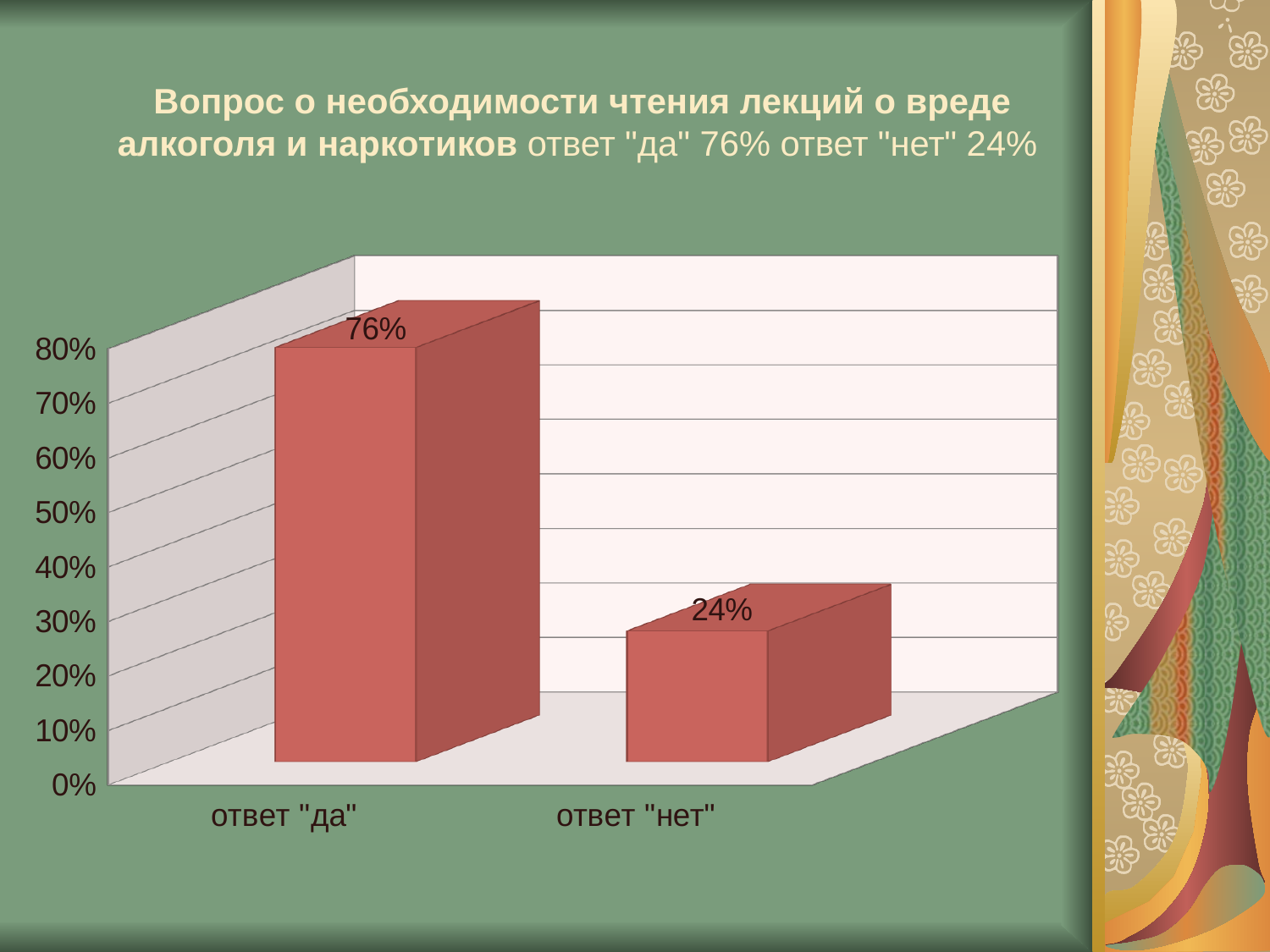
What is the value for ответ "нет"? 24% Which category has the highest value? ответ "да" Is the value for ответ "нет" greater or less than 30%? less Is the value for ответ "да" greater or less than 70%? greater What is the value for ответ "да"? 76% Which category has the lowest value? ответ "нет" What is the difference between the values for ответ "да" and ответ "нет"? 52% Which is larger, the value for ответ "да" or ответ "нет"? ответ "да" What is the highest value shown on the vertical axis? 80% How many categories are shown on the chart? 2 What is the total of the two values shown on the chart? 100% What kind of chart is shown on the slide? bar chart